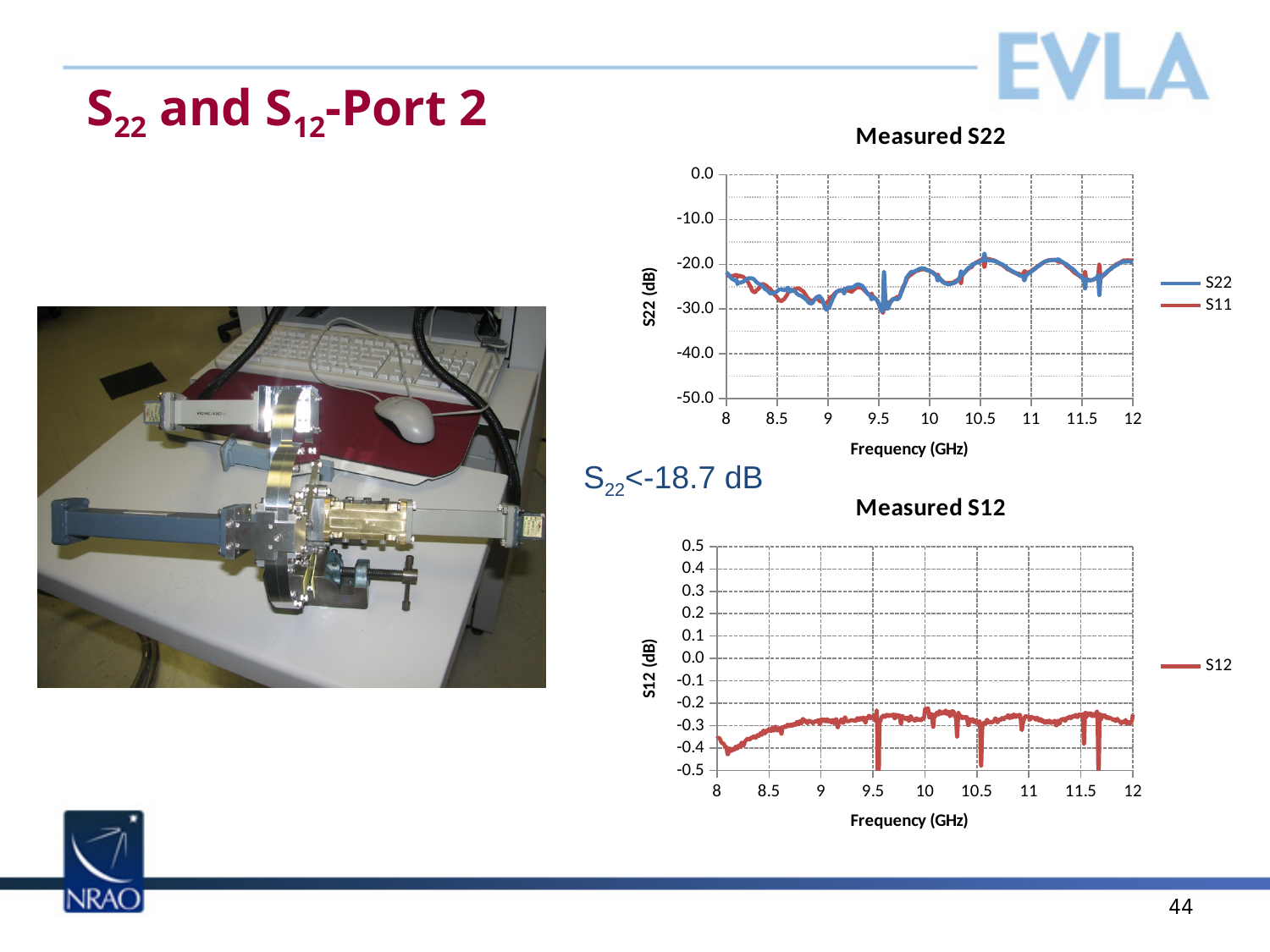
How many series does the legend of the "Measured S22" chart list? 2 What kind of chart is the "Measured S22" chart? line chart In the "Measured S12" chart, does the S12 line rise or fall between 8 GHz and 9 GHz? rise In the "Measured S22" chart, is the S22 value at 9 GHz greater or less than -20.0? less In the "Measured S22" chart, is the S22 value at 9 GHz greater or less than -40.0? greater How many series does the legend of the "Measured S12" chart list? 1 In the "Measured S12" chart, is the S12 value at 8 GHz greater or less than -0.5? greater In the "Measured S22" chart, which series is drawn in blue? S22 In the "Measured S22" chart, does the S22 line rise or fall between 8 GHz and 9 GHz? fall What is the x-axis title of the "Measured S12" chart? Frequency (GHz) What kind of chart is the "Measured S12" chart? line chart